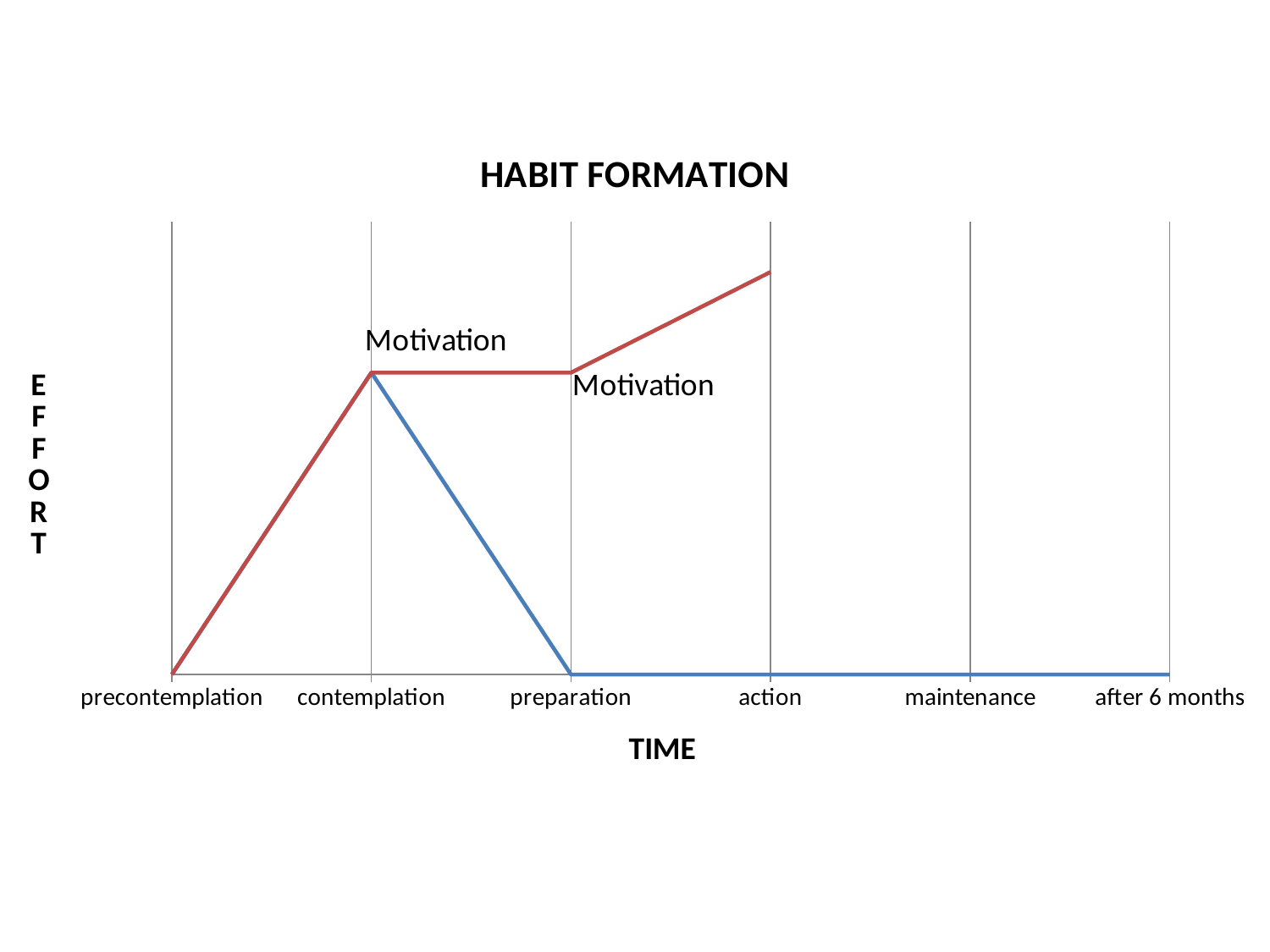
What kind of chart is shown on the slide? line chart Does the blue line rise, fall or stay flat from preparation to after 6 months? stay flat Does the red line rise or fall between precontemplation and contemplation? rise What is the title of the chart? HABIT FORMATION Does the red line rise, fall or stay flat between contemplation and preparation? stay flat At which category does the red line reach its highest point? action What is the label of the vertical axis? EFFORT At the action stage, which line is higher, the red line or the blue line? red line How many categories are labelled along the x axis? 6 How many lines are plotted on the chart? 2